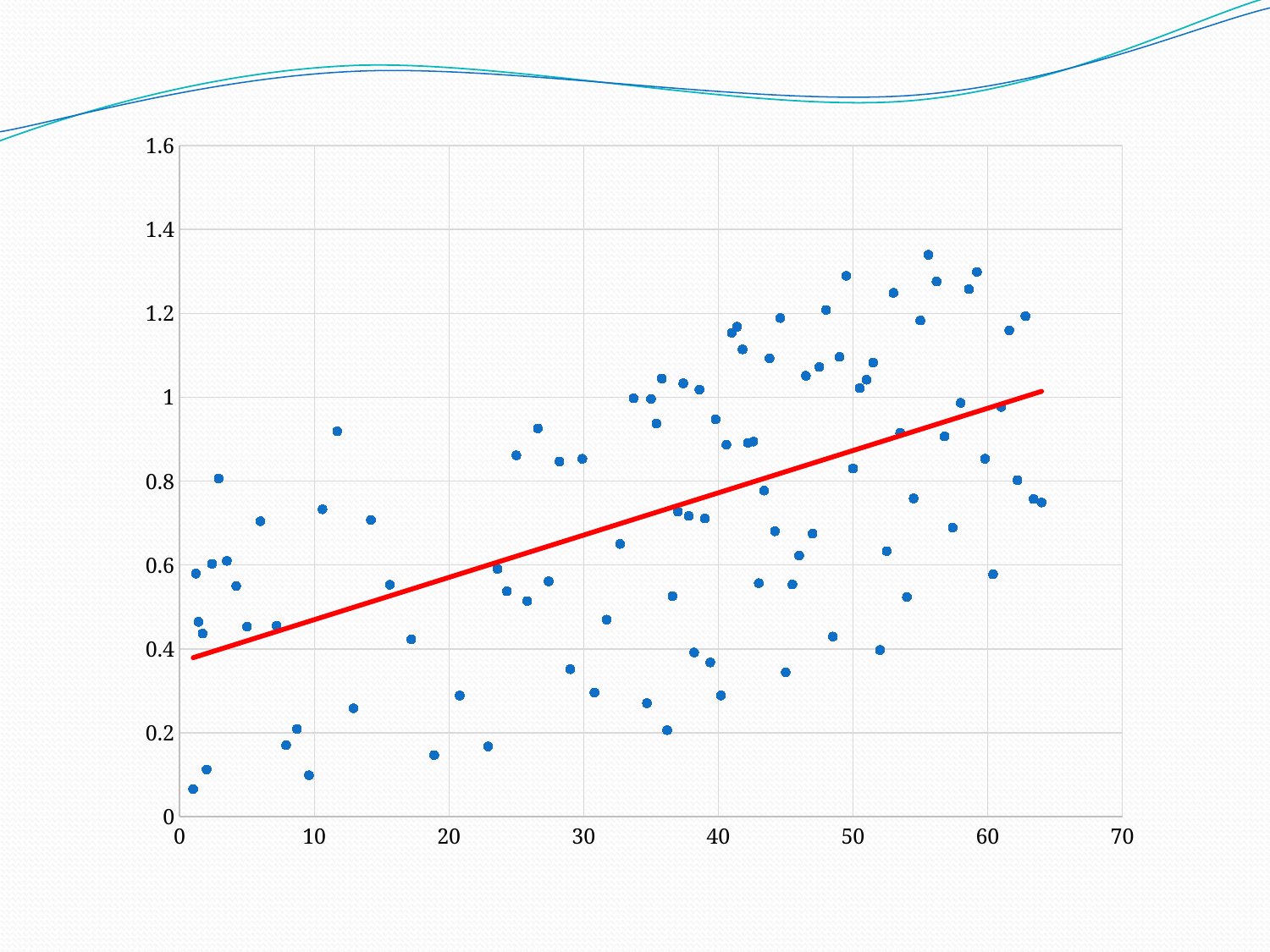
Is the value of the red line at its left end (near x = 0) greater or less than 0.6? less Is the highest plotted point greater or less than 1.2 on the y-axis? greater What is the maximum value shown on the y-axis? 1.6 Is the value of the red line at x = 60 greater or less than 0.8? greater Do the plotted points generally rise or fall as the x-axis value increases? rise What kind of chart is shown on the slide? scatter chart What is the maximum value shown on the x-axis? 70 Does the red line slope upward or downward from left to right? upward